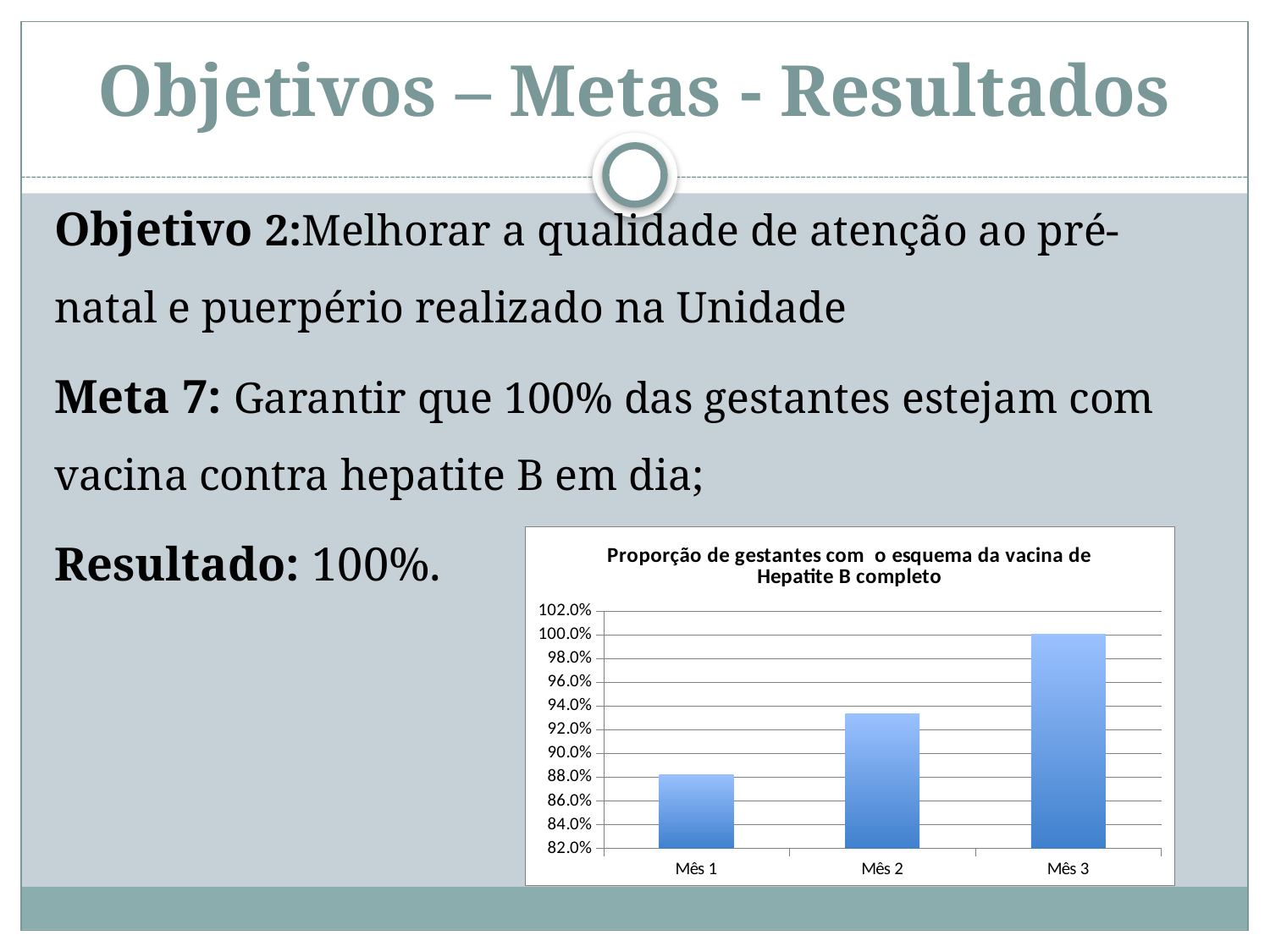
Is the value for Mês 2 greater or less than 92.0%? greater Is the value for Mês 2 greater or less than 94.0%? less What kind of chart is shown on the slide? bar chart Which month has the lowest proportion in the chart? Mês 1 Which month has the highest proportion in the chart? Mês 3 What is the value for Mês 3 in the chart? 100.0% What is the title of the chart? Proporção de gestantes com o esquema da vacina de Hepatite B completo How many categories are plotted on the x axis of the chart? 3 Is the value for Mês 1 greater or less than 90.0%? less Do the values rise or fall from Mês 1 to Mês 3? rise What is the highest tick label shown on the y axis of the chart? 102.0% Which is larger, the value for Mês 1 or the value for Mês 2? Mês 2